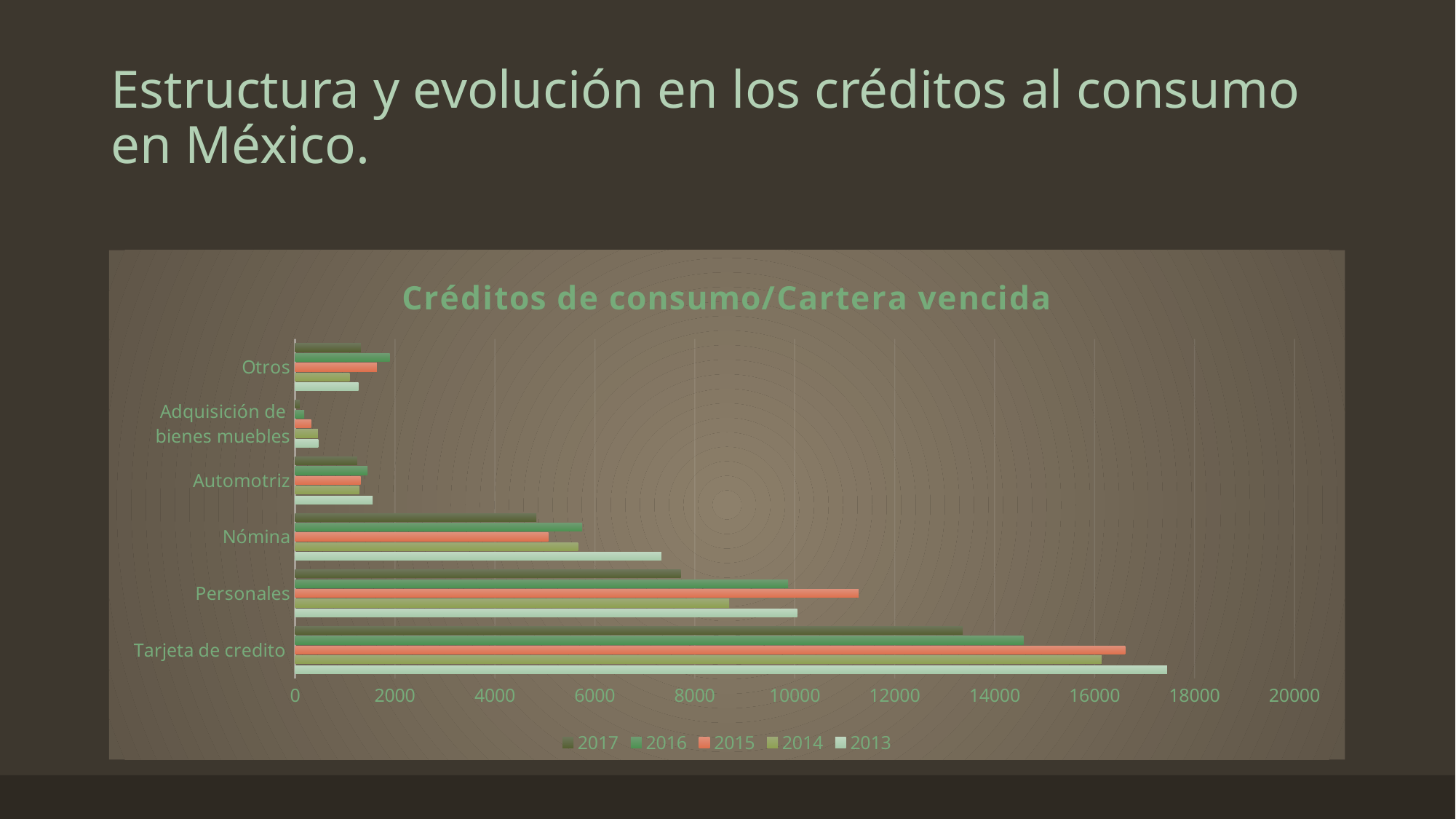
For Personales, which is larger: the 2015 value or the 2014 value? 2015 Is the 2015 value for Personales greater or less than 10000? greater Which series is shown in orange in the chart legend? 2015 How many categories are shown on the vertical axis of the chart? 6 Is the 2013 value for Nómina greater or less than 8000? less Which category has the lowest value for the 2015 series? Adquisición de bienes muebles How many series does the legend of the chart list? 5 For Tarjeta de credito, which is larger: the 2013 value or the 2017 value? 2013 Which category has the highest value for the 2013 series? Tarjeta de credito Is the 2015 value for Tarjeta de credito greater or less than 16000? greater What kind of chart is shown on the slide? bar chart What is the title of the chart? Créditos de consumo/Cartera vencida